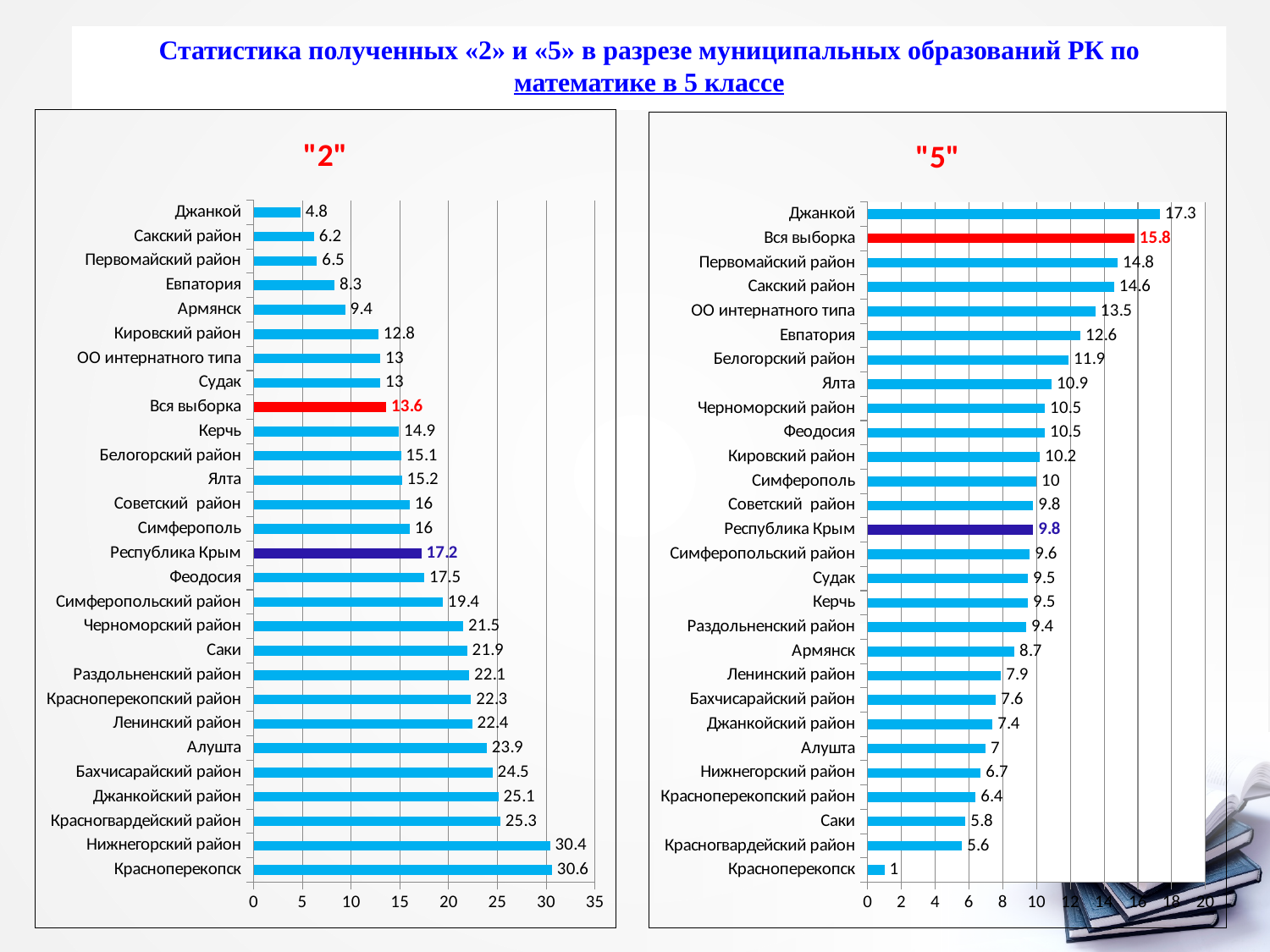
In the "2" chart, which category has the lowest value? Джанкой In the "5" chart, which category has the highest value? Джанкой In the "2" chart, which is larger: Керчь or Ялта? Ялта In the "2" chart, what is the difference between Нижнегорский район and Вся выборка? 16.8 In the "2" chart, what is the value for Республика Крым? 17.2 In the "5" chart, what is the difference between Джанкой and Республика Крым? 7.5 In the "5" chart, which category has the lowest value? Красноперекопск What type of chart is the "5" chart? Bar chart In the "5" chart, what is the value for Вся выборка? 15.8 In the "2" chart, what is the value for Красноперекопск? 30.6 In the "5" chart, what colour is the bar for Вся выборка? Red In the "2" chart, how many categories are shown? 28